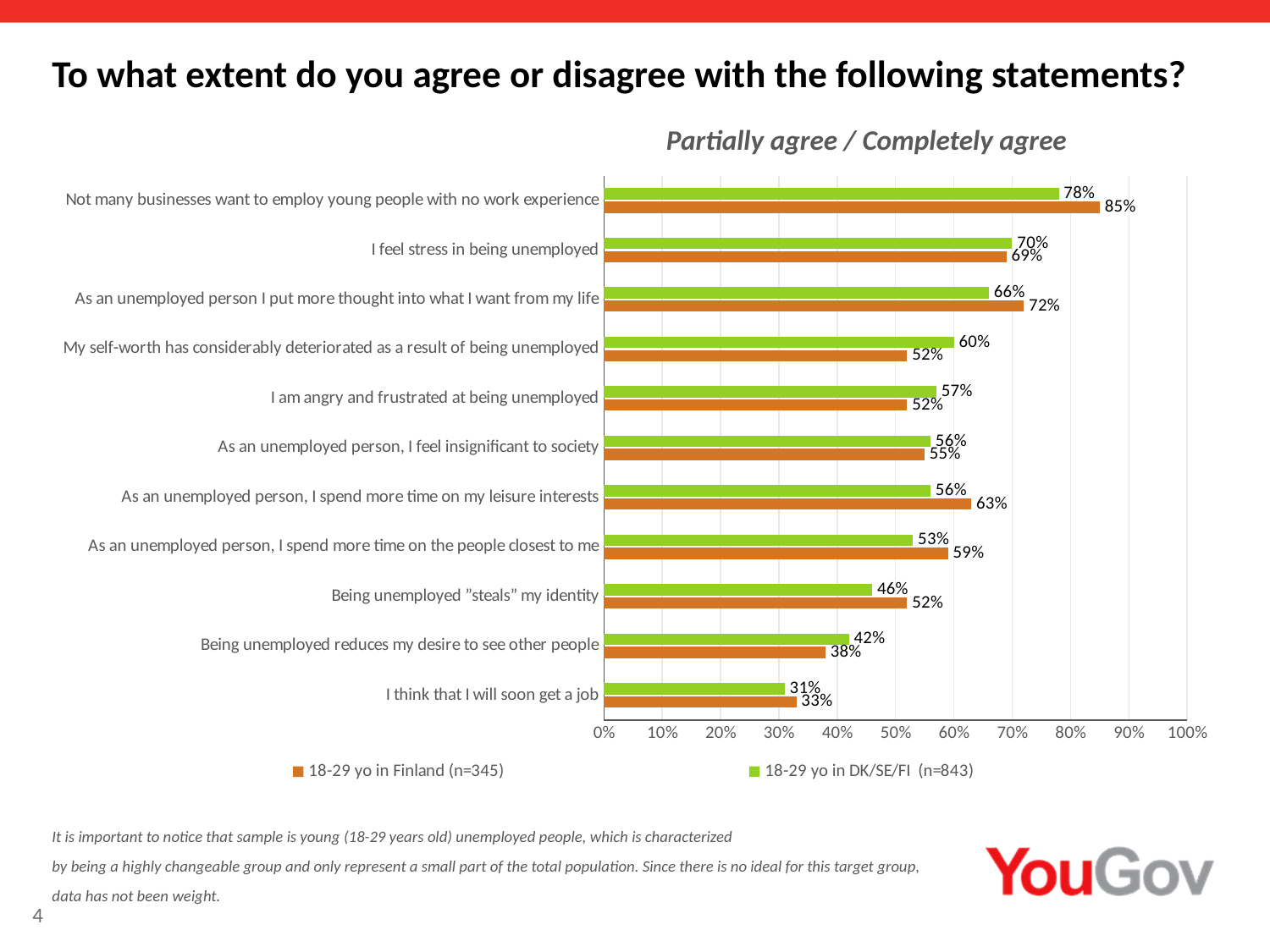
What is the difference between the Finland and DK/SE/FI values for "As an unemployed person, I spend more time on my leisure interests"? 7 percentage points Which statement has the highest agreement among 18-29 yo in DK/SE/FI? Not many businesses want to employ young people with no work experience How many series does the legend list? 2 What is the value for 18-29 yo in DK/SE/FI for the statement "My self-worth has considerably deteriorated as a result of being unemployed"? 60% Which colour represents 18-29 yo in Finland (n=345) in the chart? Orange What percentage of 18-29 yo in Finland agree with "I think that I will soon get a job"? 33% For "Being unemployed reduces my desire to see other people", which group has the higher value: 18-29 yo in Finland or 18-29 yo in DK/SE/FI? 18-29 yo in DK/SE/FI What type of chart is shown on the slide? Bar chart What percentage of 18-29 year olds in Finland agree that not many businesses want to employ young people with no work experience? 85% Is the value for 18-29 yo in Finland for "Being unemployed "steals" my identity" greater or less than 50%? greater How many statements are shown on the chart? 11 Which statement has the lowest agreement among 18-29 yo in Finland? I think that I will soon get a job